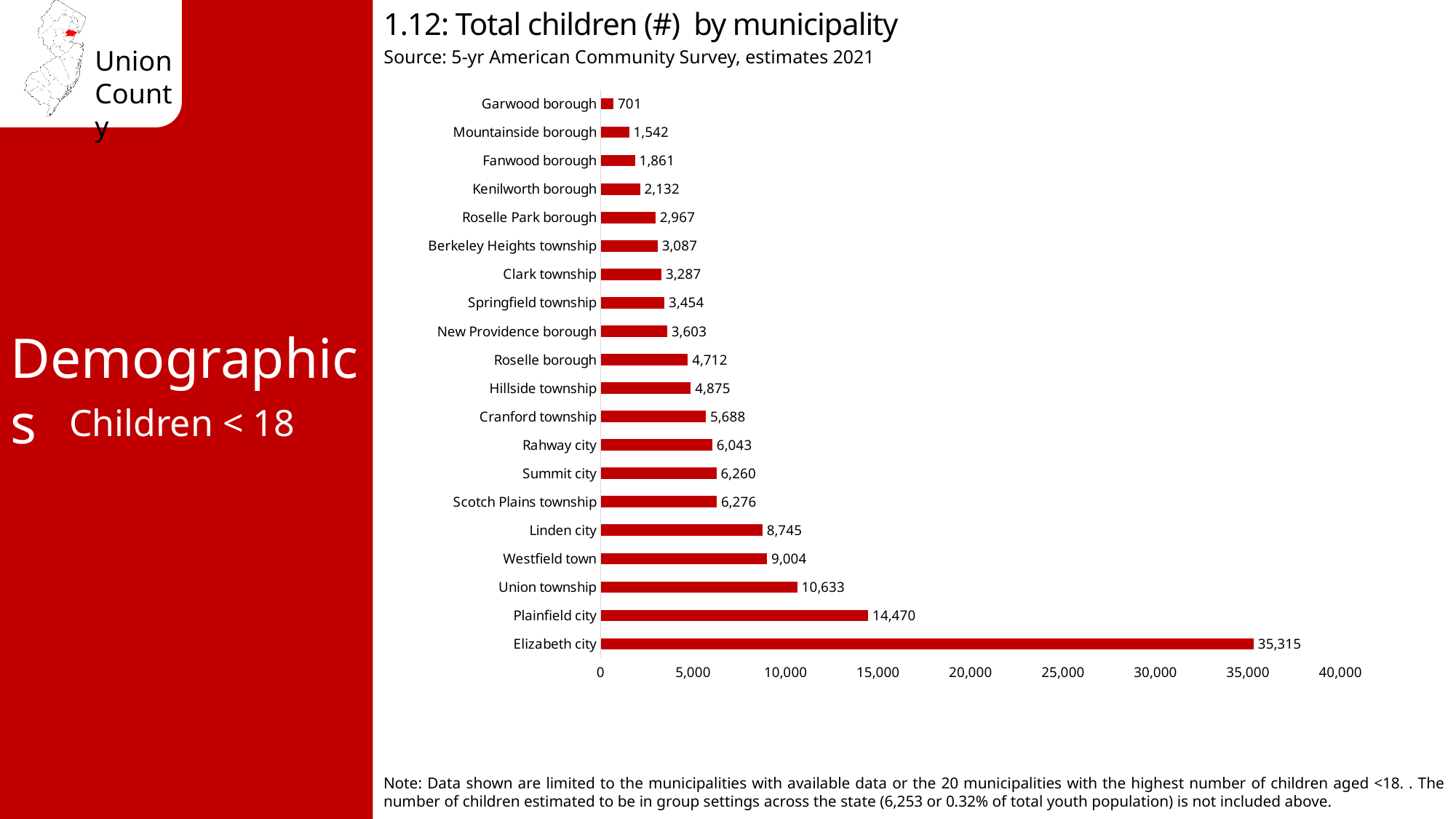
What is the total number of children in Cranford township? 5,688 What is the title of the chart? 1.12: Total children (#) by municipality What is the difference in the number of children between Plainfield city and Union township? 3,837 What is the total number of children in Westfield town? 9,004 What is the total number of children in Elizabeth city? 35,315 What type of chart is used to show total children by municipality? Bar chart How many municipalities are shown in the chart? 20 Which municipality has the highest number of children? Elizabeth city What is the source of the data shown in the chart? 5-yr American Community Survey, estimates 2021 Is the value for Union township greater or less than 10,000? greater Which municipality has the lowest number of children? Garwood borough Which has more children, Linden city or Rahway city? Linden city